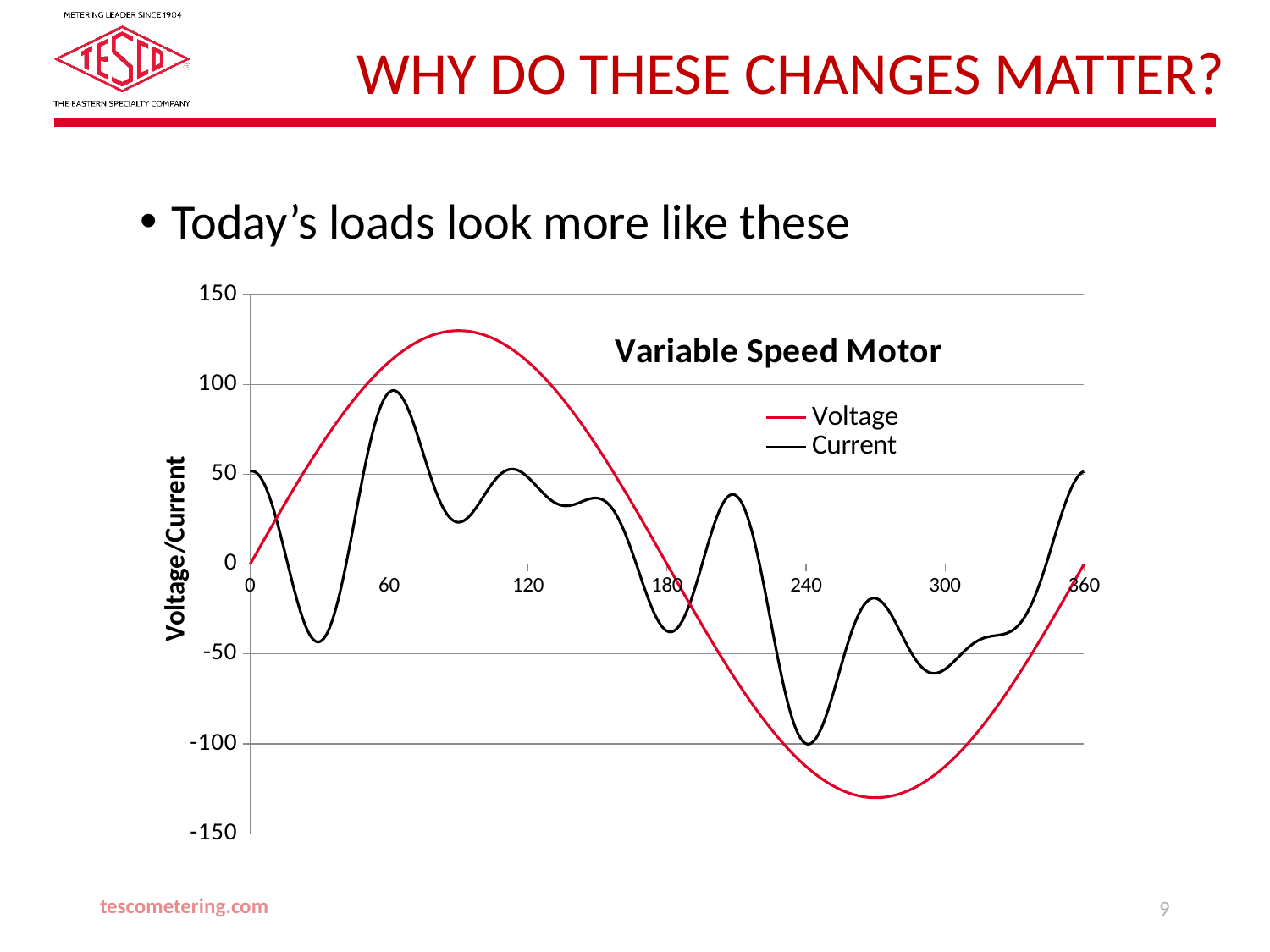
Is the value of the Current series at x = 180 greater or less than 0? less What is the value of the Voltage series at x = 0? 0 What kind of chart is shown on the slide? line chart Is the peak value of the Voltage series greater or less than 100? greater Is the minimum value of the Voltage series greater or less than -100? less What is the value of the Voltage series at x = 180? 0 How many series does the chart legend list? 2 What colour is the Voltage line in the chart? red Which series reaches the higher peak value, Voltage or Current? Voltage At x = 90, which series has the higher value, Voltage or Current? Voltage What is the title of the chart? Variable Speed Motor